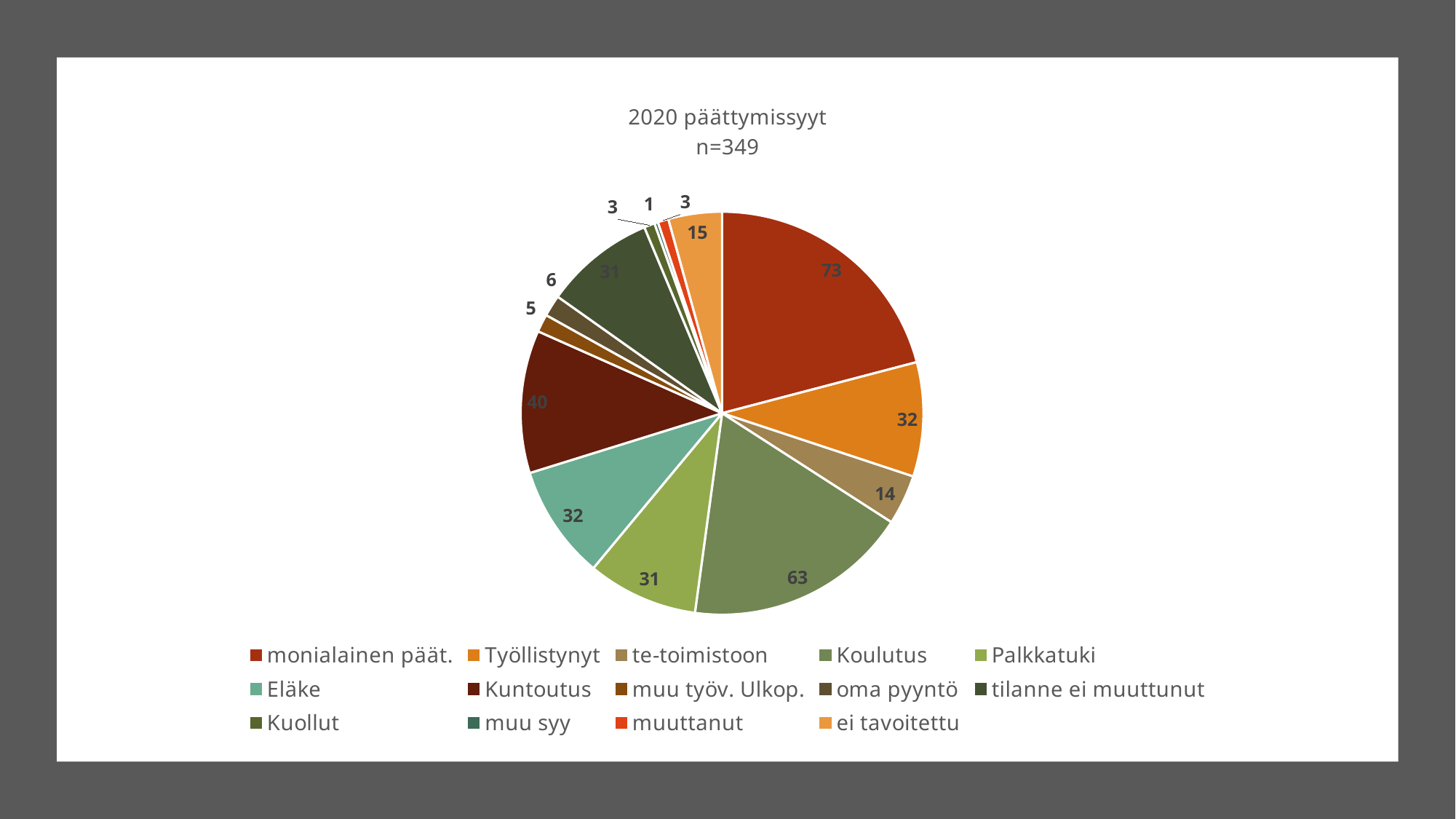
What is the value for monialainen päät.? 73 What type of chart is shown on the slide? pie chart What is the difference between the values for monialainen päät. and Koulutus? 10 What is the title of the chart? 2020 päättymissyyt n=349 How many categories does the legend list? 14 Which category has the largest slice? monialainen päät. Which is larger, the value for Kuntoutus or the value for Eläke? Kuntoutus What is the value for Kuntoutus? 40 Which category has the smallest slice? muu syy What is the value for ei tavoitettu? 15 What is the difference between the values for te-toimistoon and oma pyyntö? 8 What is the value for Koulutus? 63